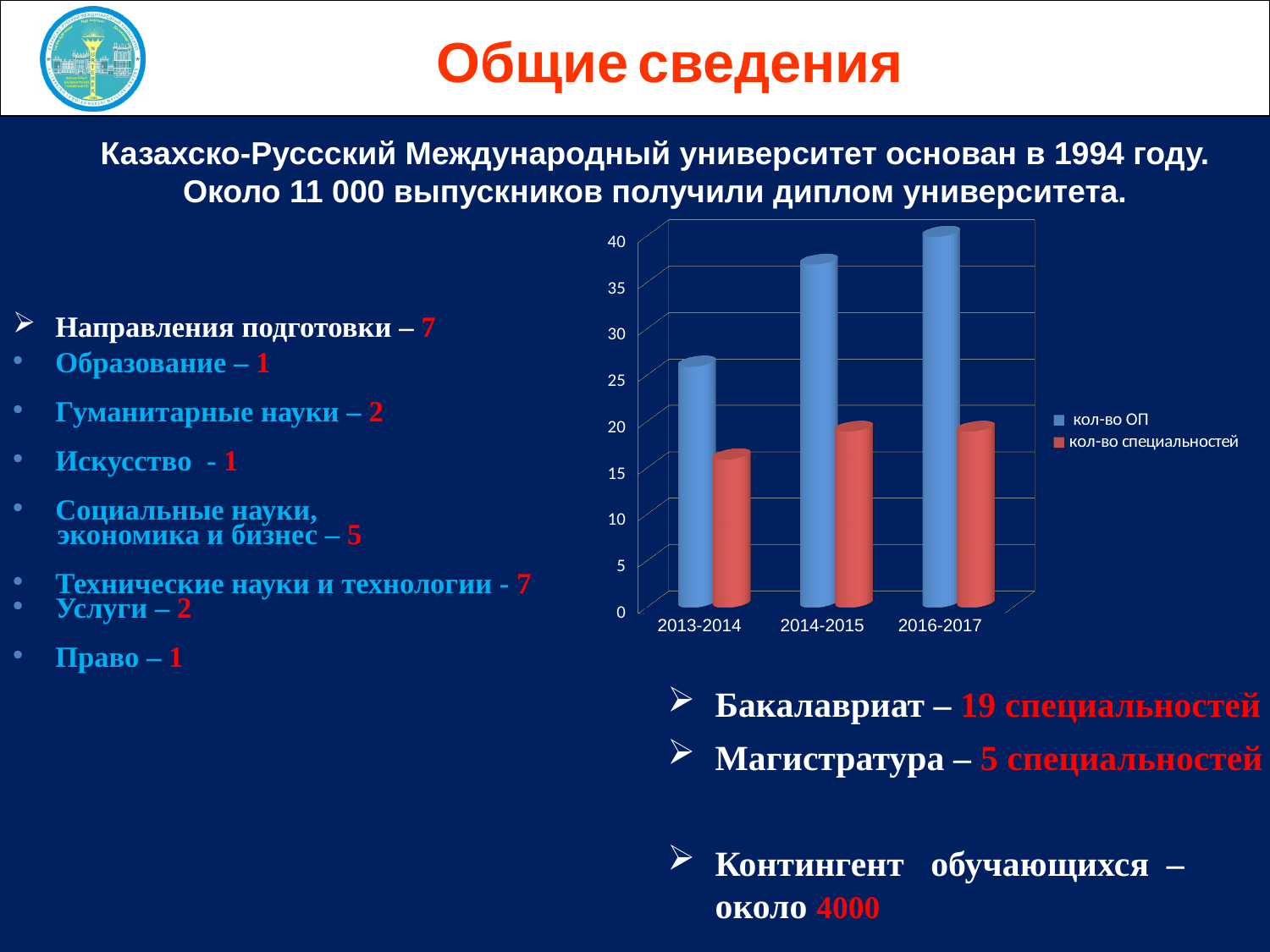
In which academic year is the value for кол-во ОП lowest? 2013-2014 How many categories (academic years) are shown on the x axis of the chart? 3 How many series does the chart legend list? 2 In which academic year is the value for кол-во ОП highest? 2016-2017 Which series is shown in red in the chart? кол-во специальностей In 2016-2017, which is larger: кол-во ОП or кол-во специальностей? кол-во ОП Is the value for кол-во специальностей in 2013-2014 greater or less than 20? less Which series is shown in blue in the chart? кол-во ОП What kind of chart is shown on the slide? bar chart In which academic year is the value for кол-во специальностей lowest? 2013-2014 Does the value for кол-во ОП rise or fall from 2013-2014 to 2016-2017? rise Is the value for кол-во ОП in 2014-2015 greater or less than 35? greater